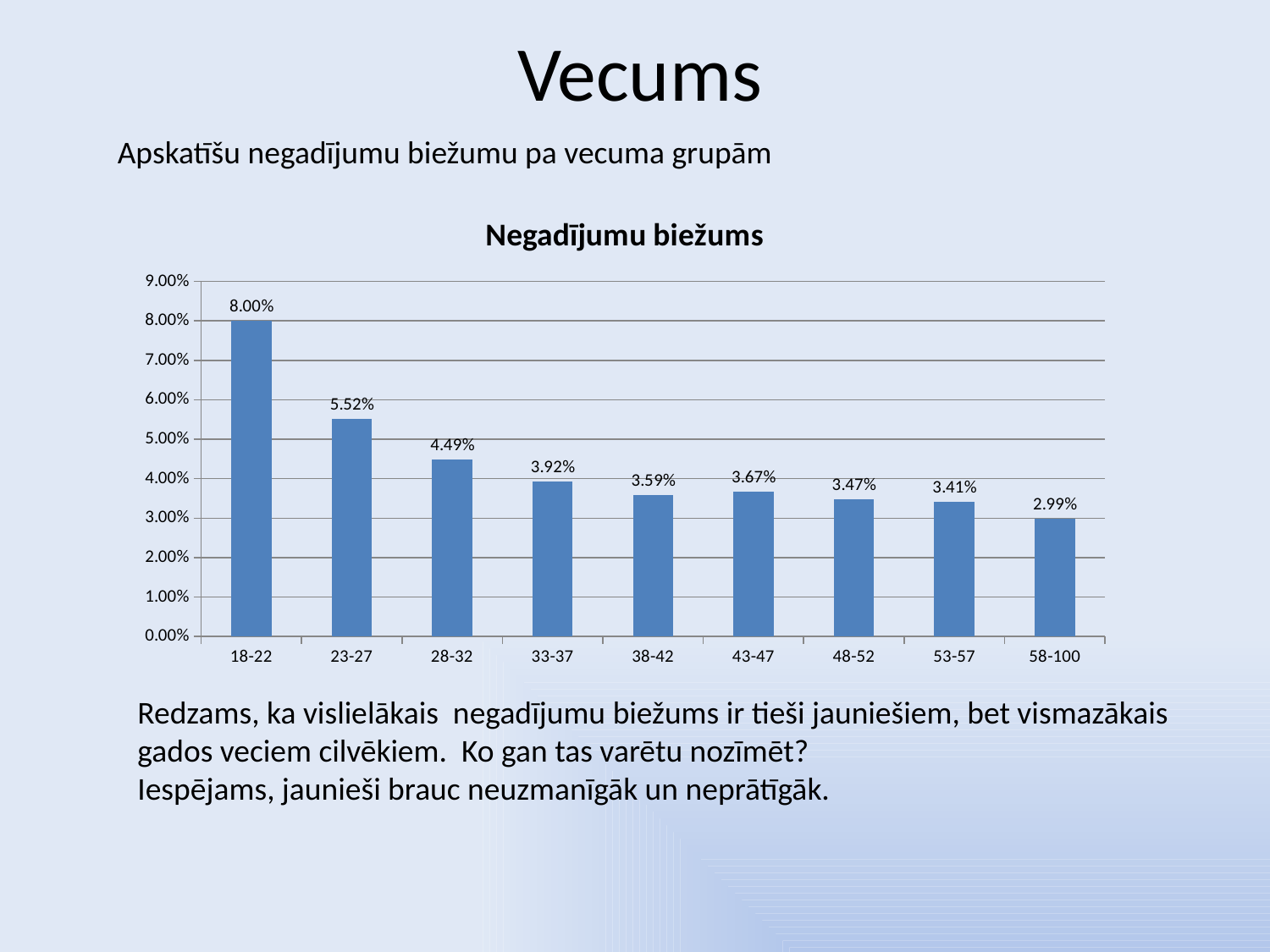
How many age groups are shown on the x axis? 9 What is the value for the 18-22 age group? 8.00% What is the difference between the values for 18-22 and 23-27? 2.48% Is the value for 23-27 greater or less than 5.00%? greater Which age group has the lowest value? 58-100 Which age group has the highest value? 18-22 Which is larger, the value for 28-32 or the value for 33-37? 28-32 What is the value for the 43-47 age group? 3.67% What kind of chart is shown? bar chart What is the value for the 58-100 age group? 2.99% Do the values generally rise or fall from left to right along the x axis? fall What is the title of the chart? Negadījumu biežums